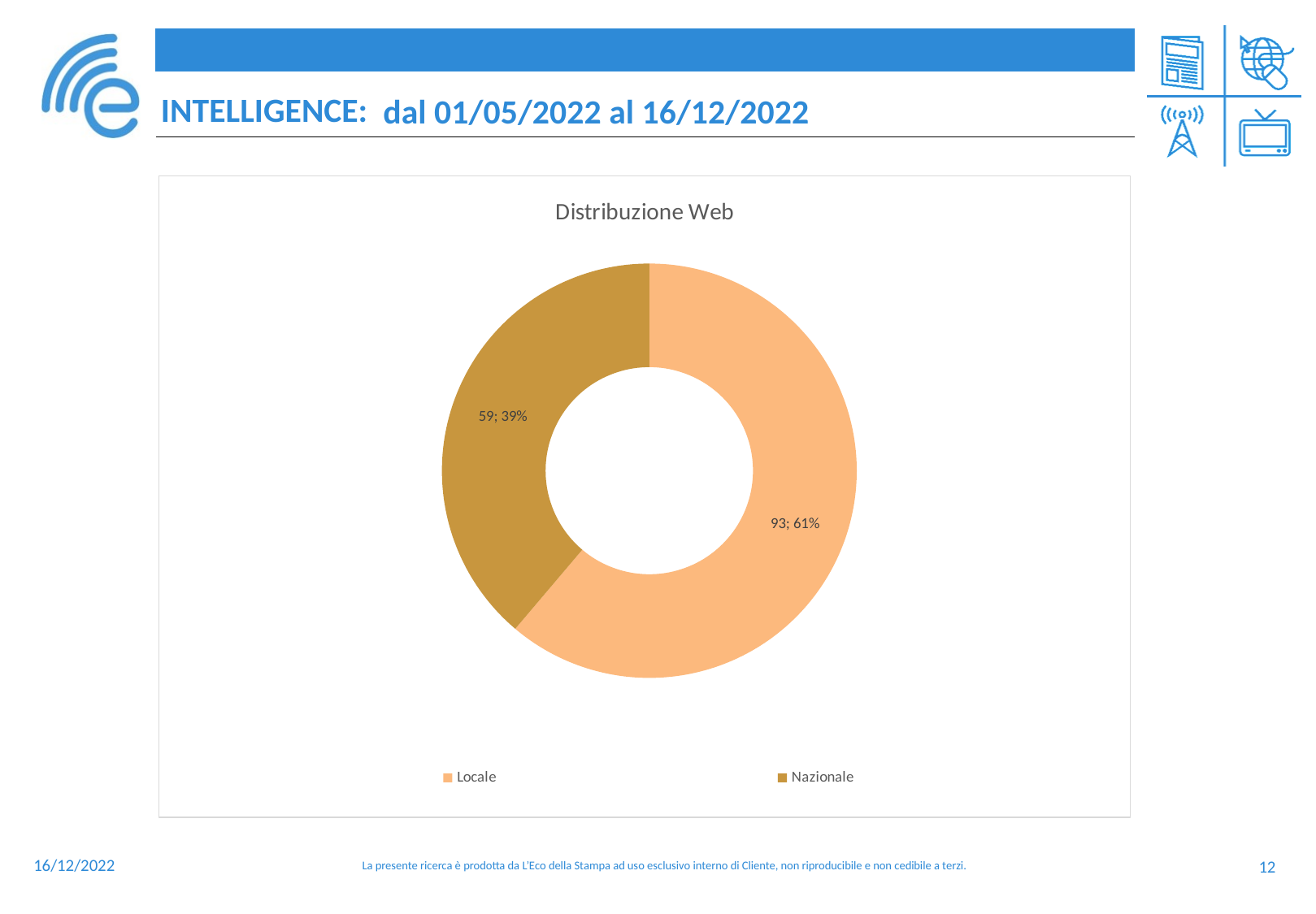
What is the title of the chart on the slide? Distribuzione Web How many categories are shown in the Distribuzione Web chart? 2 What is the difference between the Locale and Nazionale values in the Distribuzione Web chart? 34 Which category has the smallest share in the Distribuzione Web chart? Nazionale What is the total of the two values shown in the Distribuzione Web chart? 152 Which category has the largest share in the Distribuzione Web chart? Locale What is the value for Locale in the Distribuzione Web chart? 93 What percentage share does Locale have in the Distribuzione Web chart? 61% What kind of chart is the Distribuzione Web chart? Doughnut (pie) chart Which is larger in the Distribuzione Web chart, Locale or Nazionale? Locale What percentage share does Nazionale have in the Distribuzione Web chart? 39% What is the value for Nazionale in the Distribuzione Web chart? 59